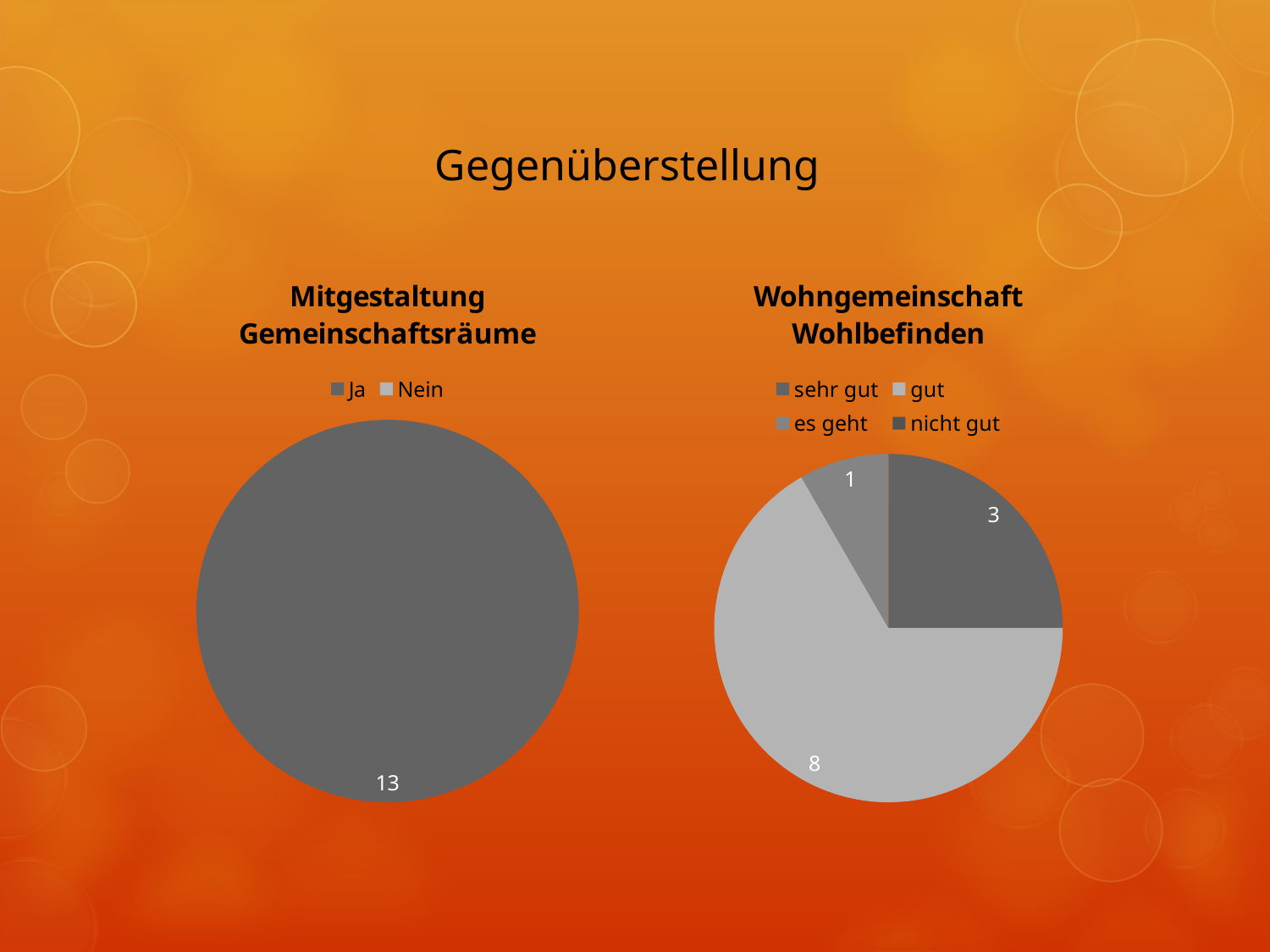
In the 'Mitgestaltung Gemeinschaftsräume' chart, what value is shown for 'Ja'? 13 In the 'Wohngemeinschaft Wohlbefinden' chart, what value is shown for 'es geht'? 1 In the 'Wohngemeinschaft Wohlbefinden' chart, which labelled slice is the smallest? es geht What kind of chart is the 'Mitgestaltung Gemeinschaftsräume' chart on the left? pie chart In the 'Wohngemeinschaft Wohlbefinden' chart, which category has the largest slice? gut How many entries does the legend of the 'Wohngemeinschaft Wohlbefinden' chart list? 4 How many entries does the legend of the 'Mitgestaltung Gemeinschaftsräume' chart list? 2 In the 'Wohngemeinschaft Wohlbefinden' chart, what value is shown for 'sehr gut'? 3 In the 'Wohngemeinschaft Wohlbefinden' chart, which is larger, 'sehr gut' or 'es geht'? sehr gut In the 'Wohngemeinschaft Wohlbefinden' chart, what is the difference between the values for 'gut' and 'sehr gut'? 5 In the 'Wohngemeinschaft Wohlbefinden' chart, what value is shown for 'gut'? 8 What is the title of the slide above the two charts? Gegenüberstellung